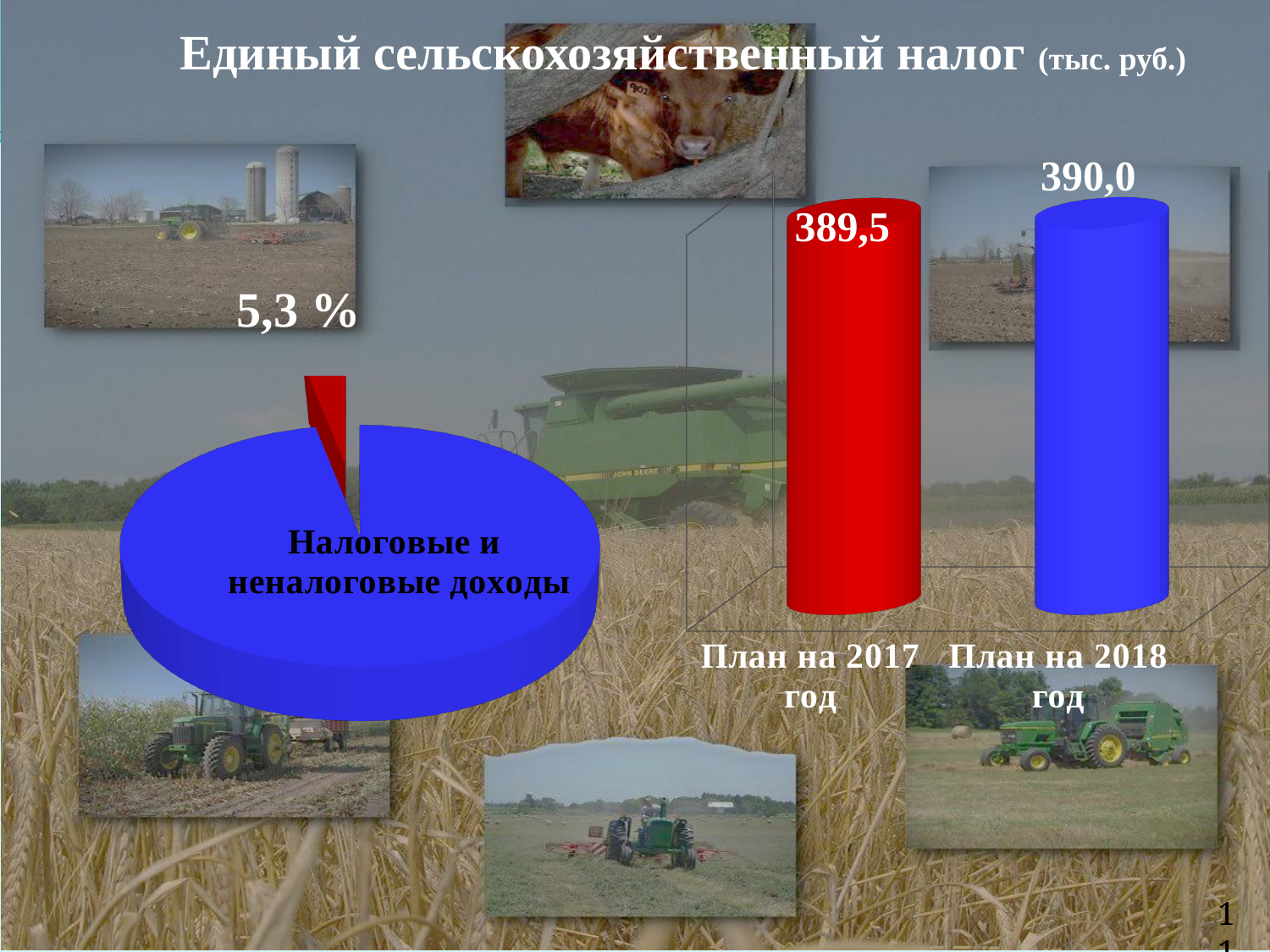
What kind of chart is shown on the left side of the slide? Pie chart In the bar chart on the right, what is the value for План на 2017 год? 389,5 In the pie chart on the left, what share does the red slice represent? 5,3 % In the bar chart on the right, how many bars are plotted? 2 In the bar chart on the right, do the values rise or fall from План на 2017 год to План на 2018 год? Rise What kind of chart is shown on the right side of the slide? Bar chart What is the title of the slide? Единый сельскохозяйственный налог (тыс. руб.) In the pie chart on the left, how many slices are there? 2 In the bar chart on the right, what is the value for План на 2018 год? 390,0 In the bar chart on the right, which category has the higher value according to the data labels? План на 2018 год In the bar chart on the right, what is the difference between the values for План на 2018 год and План на 2017 год? 0,5 In the bar chart on the right, which category has the lower value according to the data labels? План на 2017 год